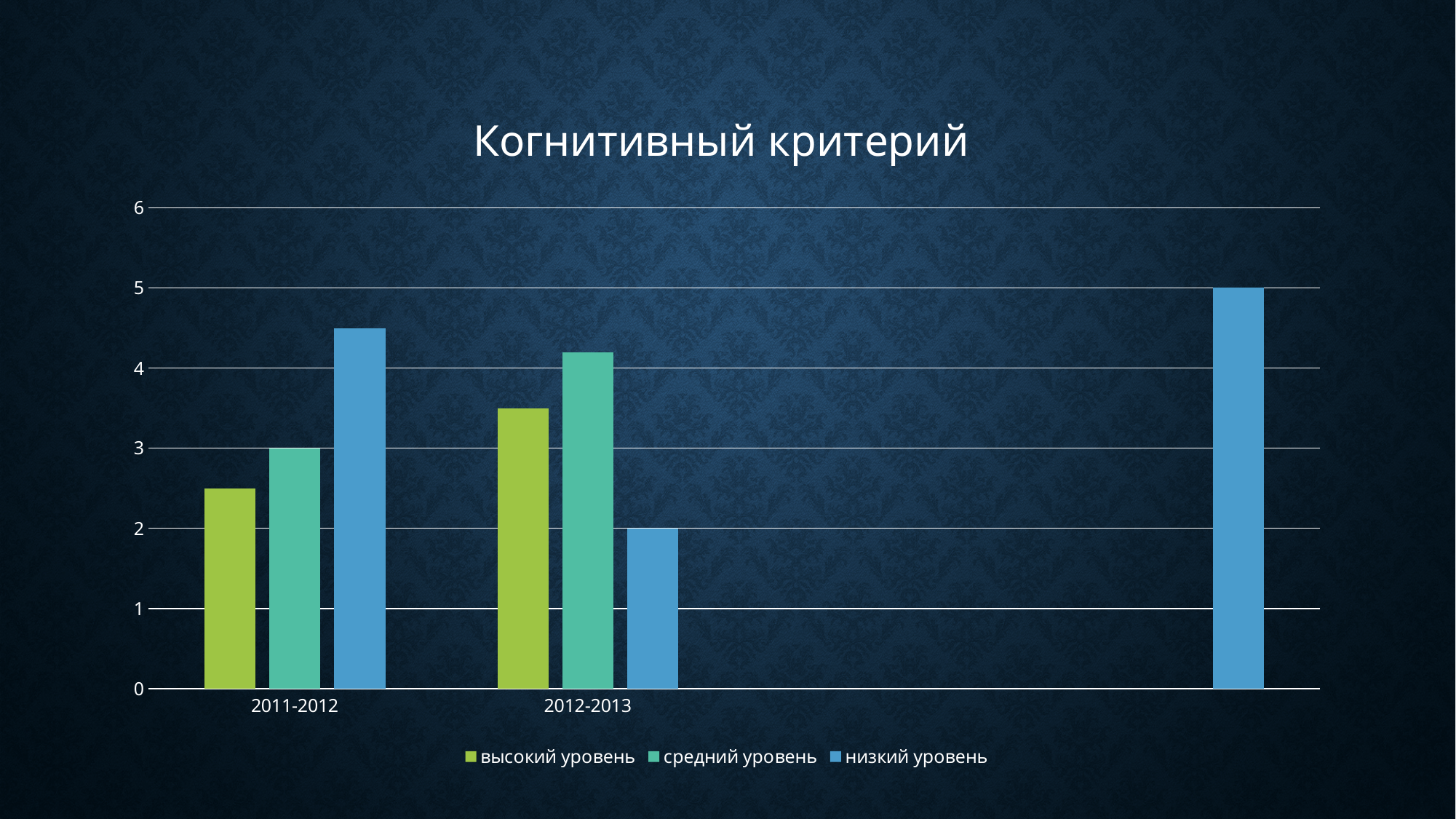
How many series does the legend list? 3 Is the value for низкий уровень in 2011-2012 greater or less than 4? greater Which is larger for высокий уровень: the value in 2011-2012 or in 2012-2013? 2012-2013 What kind of chart is shown on the slide? bar chart Does the value for низкий уровень rise or fall from 2011-2012 to 2012-2013? fall Is the value for высокий уровень in 2012-2013 greater or less than 3? greater Which series has the highest value in 2011-2012? низкий уровень What is the value for средний уровень in 2011-2012? 3 What is the title of the chart? Когнитивный критерий Is the value for высокий уровень in 2011-2012 greater or less than 3? less What is the value for низкий уровень in 2012-2013? 2 Which series has the lowest value in 2012-2013? низкий уровень